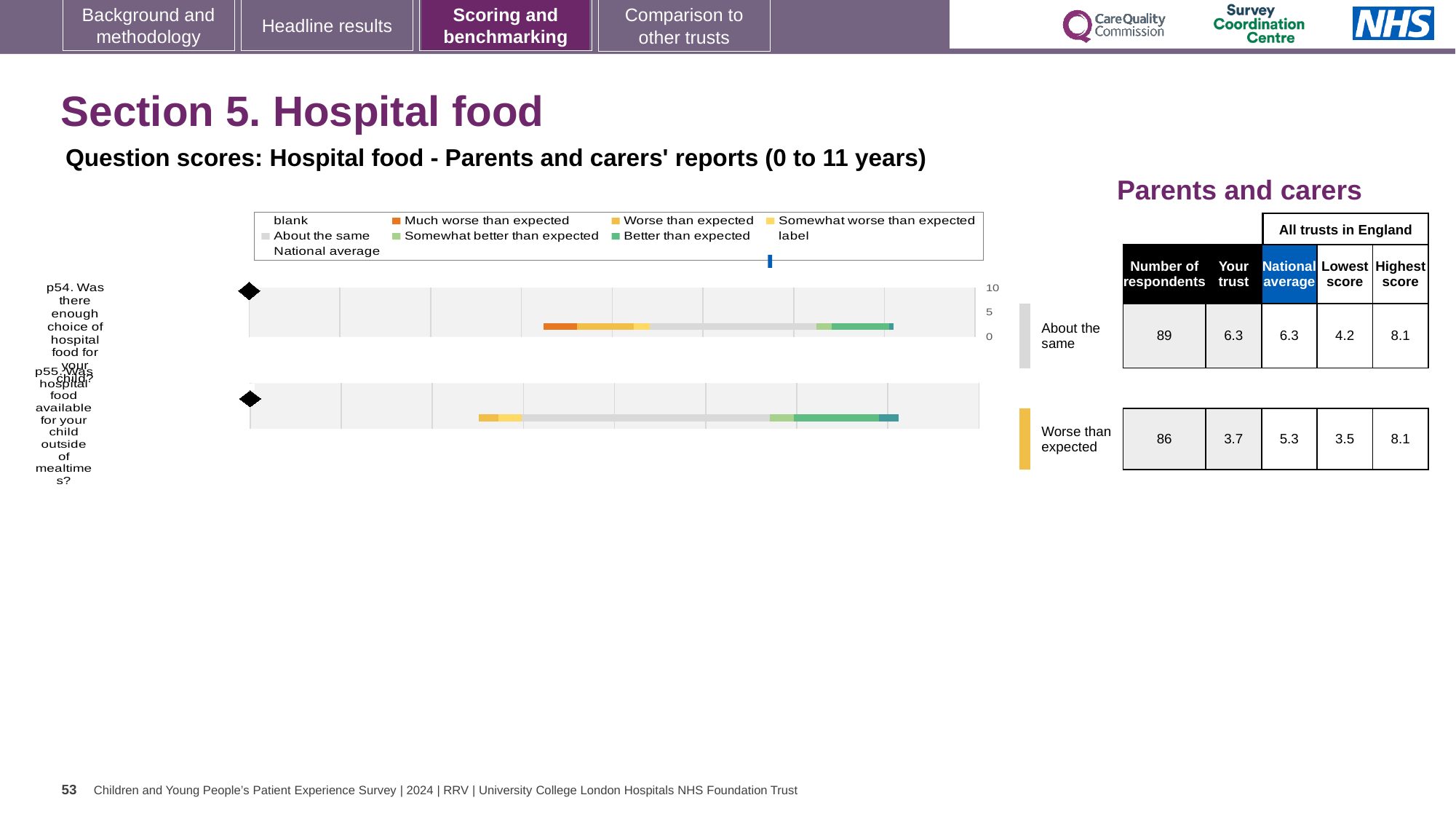
What is the number of respondents for question p54 (enough choice of hospital food)? 89 What is the lowest score among all trusts in England for question p55? 3.5 How many questions (bars) are plotted in the hospital food chart? 2 What is the 'Your trust' score for question p55 (hospital food available outside of mealtimes)? 3.7 What is the difference between the national average and the 'Your trust' score for question p55? 1.6 What is the national average score for question p54? 6.3 Which question has the higher 'Your trust' score, p54 or p55? p54 What kind of chart is used to show the question scores for hospital food? Bar chart What is the highest score among all trusts in England for question p54? 8.1 For question p55, which is larger: the 'Your trust' score or the national average? National average Which legend entry in the hospital food chart is shown in orange? Much worse than expected Which benchmark category is question p55 rated as? Worse than expected